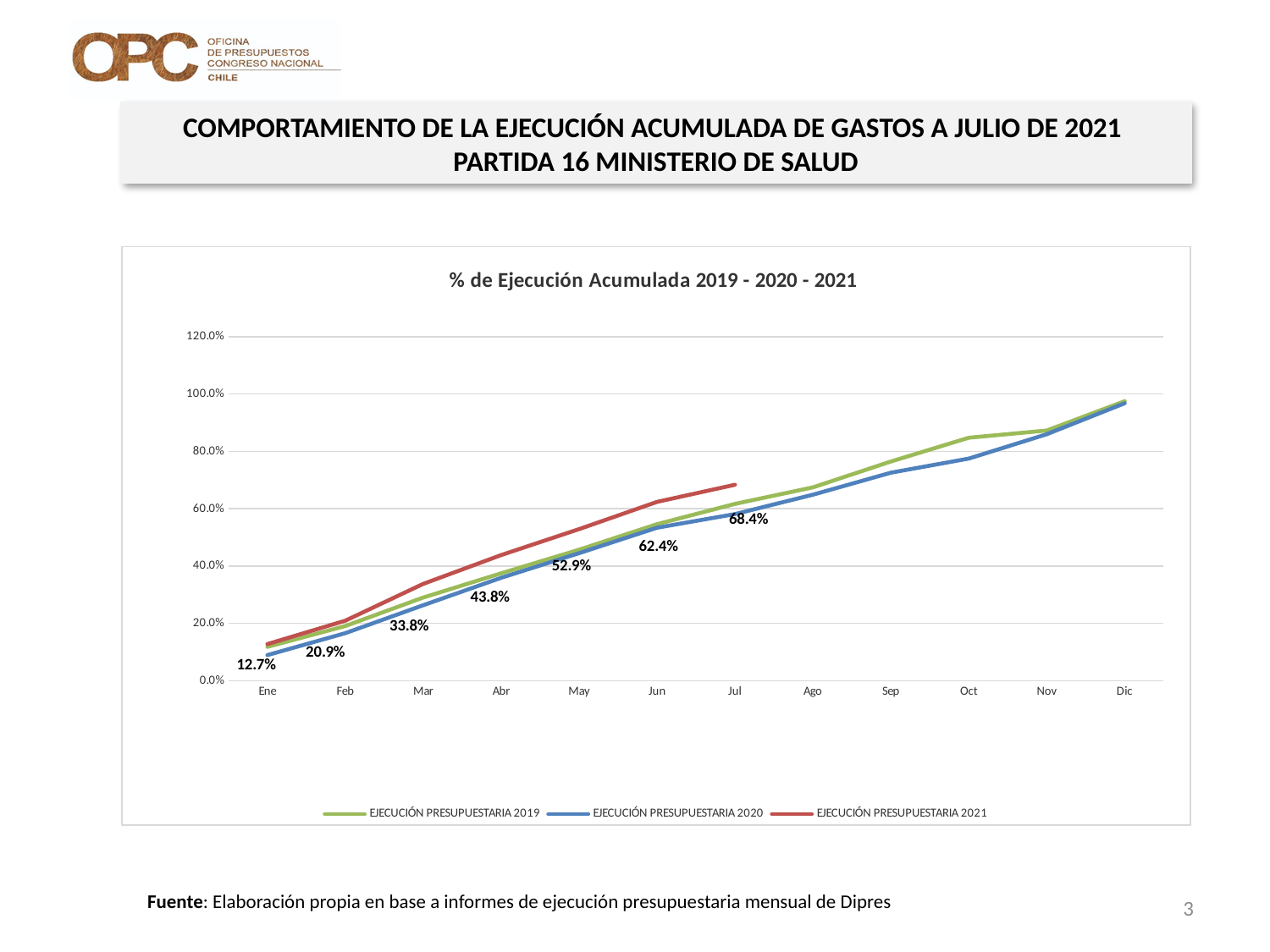
What is the value for EJECUCIÓN PRESUPUESTARIA 2021 in Ene? 12.7% In Jul, which series has the higher value, EJECUCIÓN PRESUPUESTARIA 2021 or EJECUCIÓN PRESUPUESTARIA 2020? EJECUCIÓN PRESUPUESTARIA 2021 What is the value for EJECUCIÓN PRESUPUESTARIA 2021 in Jul? 68.4% Is the value for EJECUCIÓN PRESUPUESTARIA 2020 in Sep greater or less than 80.0%? less How many series does the legend list? 3 What is the title of the chart? % de Ejecución Acumulada 2019 - 2020 - 2021 How many months are shown on the x axis? 12 Is the value for EJECUCIÓN PRESUPUESTARIA 2020 in Dic greater or less than 80.0%? greater Do the values for EJECUCIÓN PRESUPUESTARIA 2021 rise or fall from Ene to Jul? rise What is the difference between the 2021 values for Jul and Jun? 6.0% What kind of chart is shown on the slide? line chart What is the value for EJECUCIÓN PRESUPUESTARIA 2021 in Abr? 43.8%